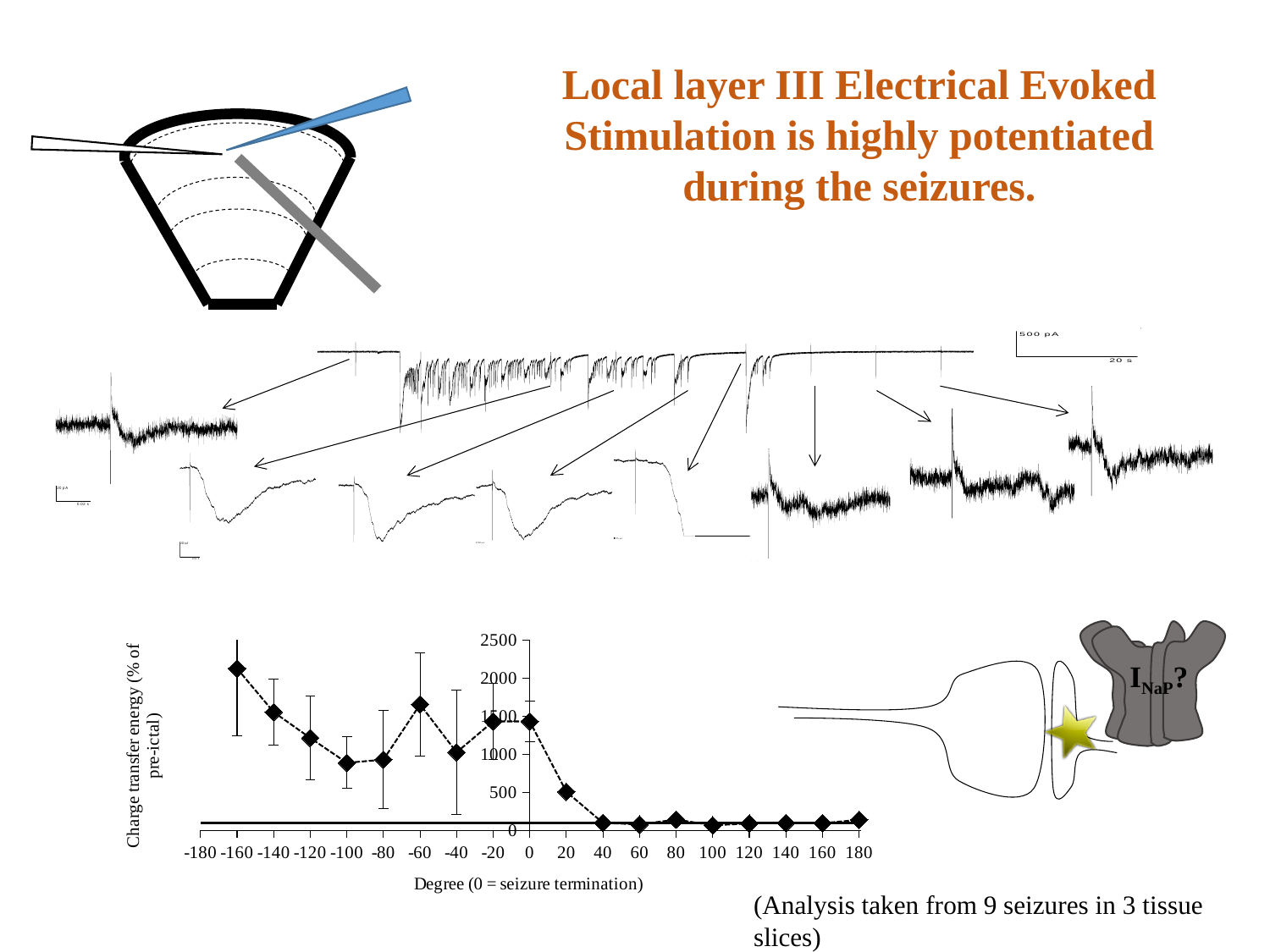
Which has the larger charge transfer energy, 0 degrees or 40 degrees? 0 degrees What is the label of the x axis of the chart? Degree (0 = seizure termination) What is the label of the y axis of the chart? Charge transfer energy (% of pre-ictal) Is the value at -160 degrees greater or less than 1500? greater Is the value at 0 degrees greater or less than 1000? greater Is the value at -60 degrees greater or less than 1000? greater Do the values rise or fall between 0 and 40 degrees? fall What kind of chart is shown at the bottom of the slide? line chart How many data points are plotted on the chart? 18 Which has the larger charge transfer energy, -160 degrees or -100 degrees? -160 degrees At which degree value is the charge transfer energy highest? -160